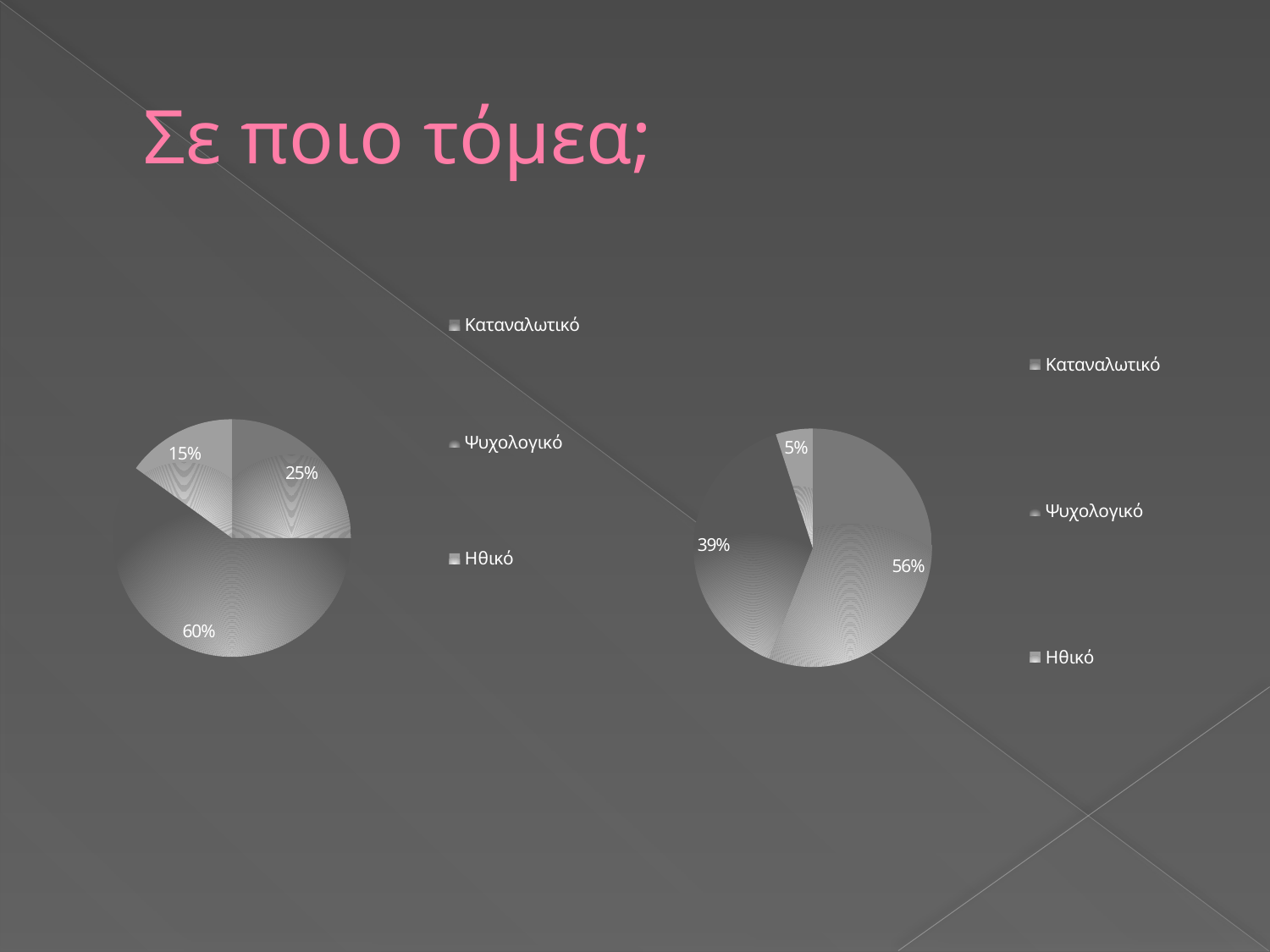
In the left pie chart, what is the value of the largest slice? 60% Which is larger: the largest slice of the left pie chart or the largest slice of the right pie chart? the largest slice of the left pie chart (60%) What kind of chart is the chart on the right of the slide? pie chart How many slices does the left pie chart have? 3 What kind of chart is the chart on the left of the slide? pie chart How many entries does the legend of the left pie chart list? 3 In the right pie chart, what is the difference between the 56% slice and the 39% slice? 17% In the left pie chart, what is the value of the smallest slice? 15% In the right pie chart, what is the value of the smallest slice? 5% How many slices does the right pie chart have? 3 In the right pie chart, what is the value of the largest slice? 56% In the left pie chart, what is the difference between the largest slice (60%) and the smallest slice (15%)? 45%